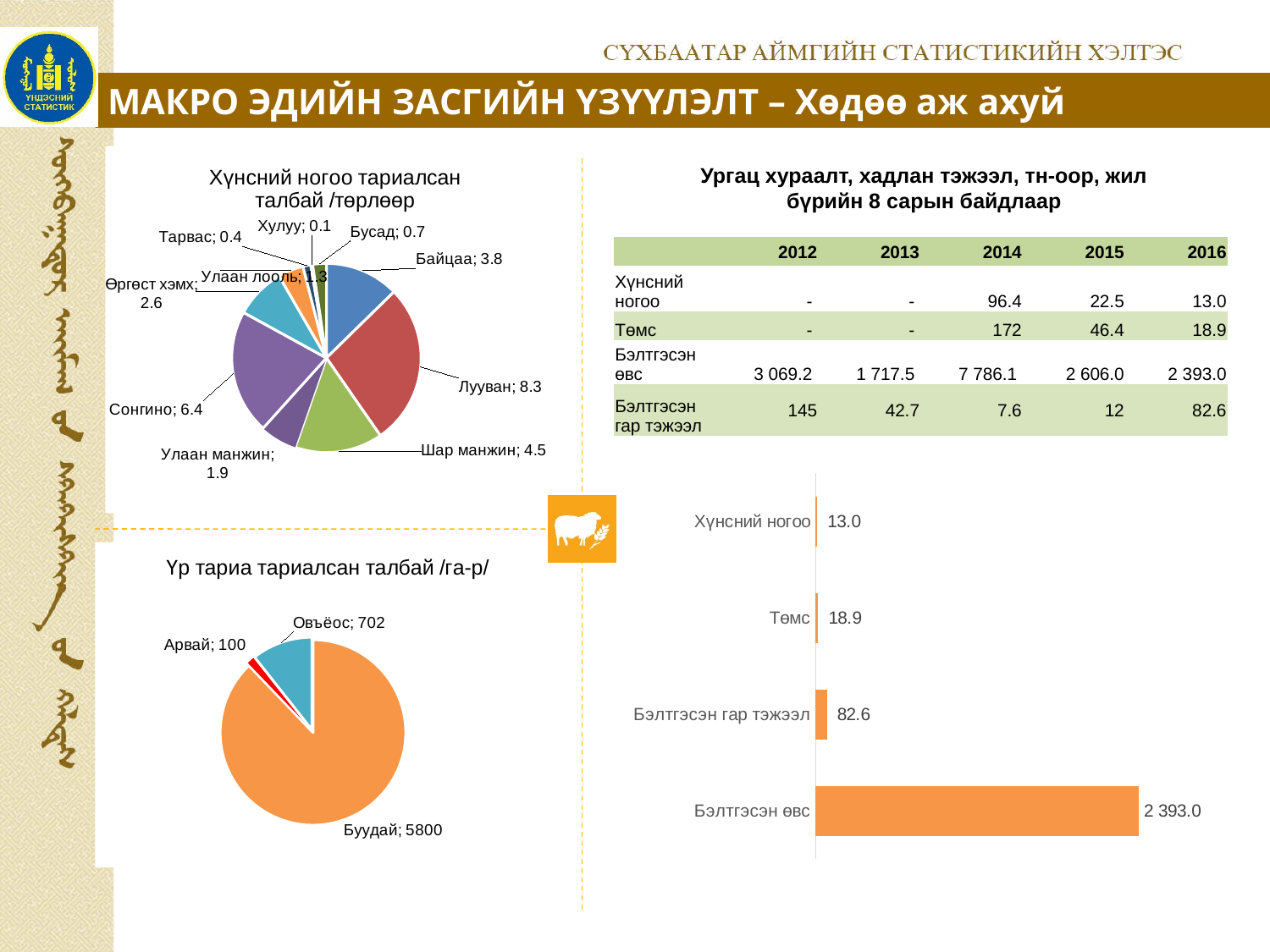
In the bottom-left pie chart 'Үр тариа тариалсан талбай /га-р/', what is the value for Овъёос? 702 In the bottom-left pie chart 'Үр тариа тариалсан талбай /га-р/', which category has the largest value? Буудай In the top-left pie chart 'Хүнсний ногоо тариалсан талбай /төрлөөр', which category has the largest value? Лууван In the top-left pie chart 'Хүнсний ногоо тариалсан талбай /төрлөөр', which category has the smallest value? Хулуу In the bottom-left pie chart 'Үр тариа тариалсан талбай /га-р/', how many categories are shown? 3 In the bar chart at the bottom right, what is the value for Бэлтгэсэн өвс? 2 393.0 In the top-left pie chart 'Хүнсний ногоо тариалсан талбай /төрлөөр', what is the difference between Сонгино and Шар манжин? 1.9 In the bottom-left pie chart 'Үр тариа тариалсан талбай /га-р/', which is larger, Арвай or Овъёос? Овъёос In the top-left pie chart 'Хүнсний ногоо тариалсан талбай /төрлөөр', how many slices are there? 10 What kind of chart is shown at the bottom right of the slide? Bar chart In the bar chart at the bottom right, what is the difference between Төмс and Хүнсний ногоо? 5.9 In the top-left pie chart 'Хүнсний ногоо тариалсан талбай /төрлөөр', what is the value for Лууван? 8.3